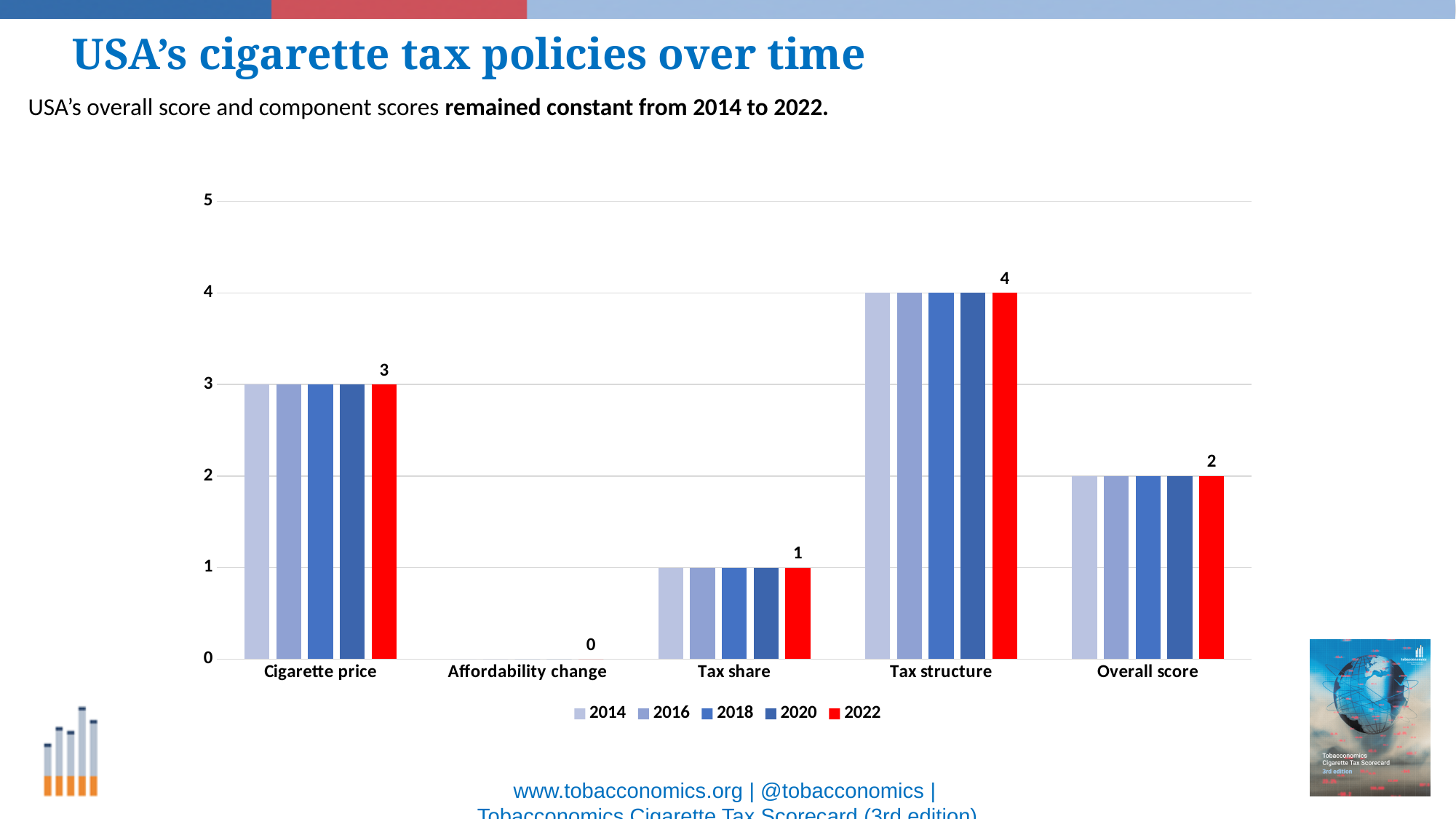
What is the 2022 value for Overall score? 2 What kind of chart is shown on the slide? Bar chart Which category has the highest 2022 value? Tax structure What is the difference between the 2022 values for Tax structure and Cigarette price? 1 How many series does the legend list? 5 What is the 2022 value for Tax structure? 4 Which category has the lowest 2022 value? Affordability change What is the 2022 value for Cigarette price? 3 What is the 2022 value for Tax share? 1 What is the 2022 value for Affordability change? 0 Which is larger in 2022: Cigarette price or Overall score? Cigarette price How many categories are shown on the x axis? 5